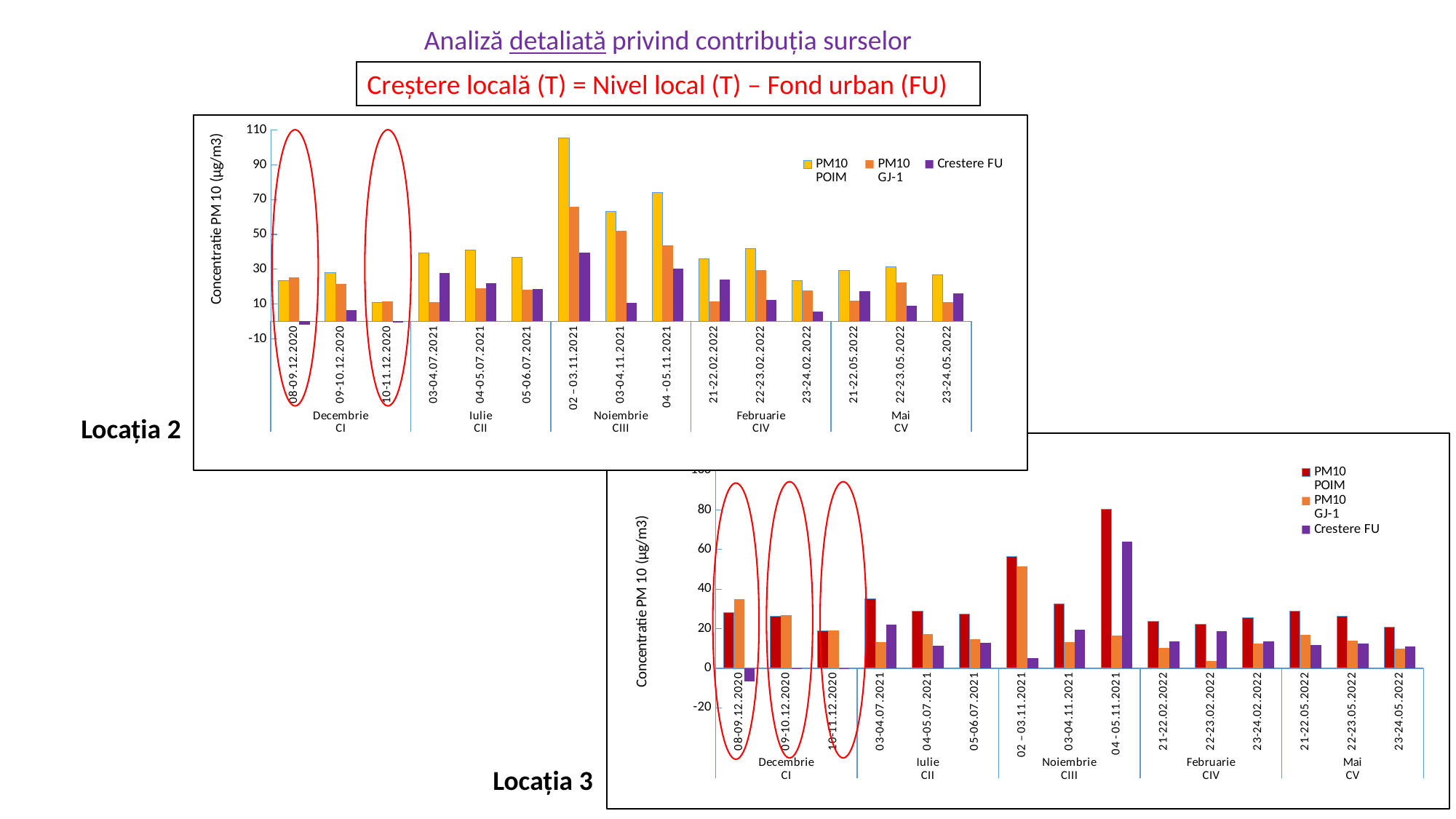
In the Locația 3 chart, which date has the highest PM10 POIM value? 04 - 05.11.2021 In the Locația 2 chart, is the PM10 POIM value for 02 – 03.11.2021 greater or less than 90? greater How many series does the legend of the Locația 2 chart list? 3 In the Locația 3 chart, for 08-09.12.2020, which is larger: PM10 POIM or PM10 GJ-1? PM10 GJ-1 In the Locația 3 chart, is the Crestere FU value for 04 - 05.11.2021 greater or less than 40? greater In the Locația 3 chart, which date has the lowest PM10 GJ-1 value? 22-23.02.2022 In the Locația 2 chart, which date has the highest PM10 POIM value? 02 – 03.11.2021 What kind of chart is used for Locația 2? Bar chart What is the y-axis label of the Locația 3 chart? Concentratie PM 10 (µg/m3) How many date categories are shown on the x axis of the Locația 3 chart? 15 In the Locația 2 chart, which date has the highest Crestere FU value? 02 – 03.11.2021 In the Locația 2 chart, for 02 – 03.11.2021, which is larger: PM10 POIM or PM10 GJ-1? PM10 POIM